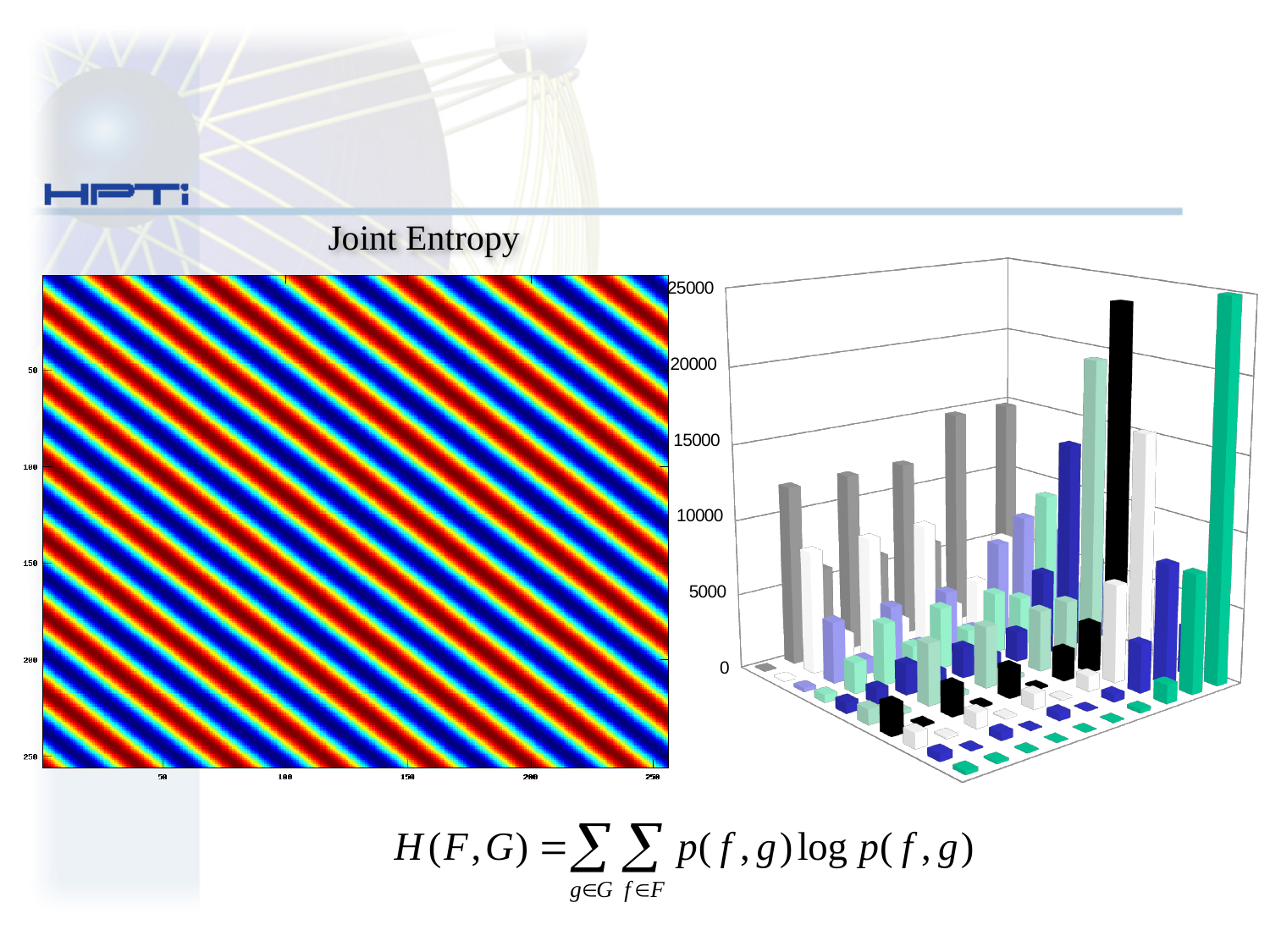
What is the highest value shown on the vertical axis of the bar chart on the right? 25000 What kind of chart is shown on the right side of the slide? bar chart In the bar chart on the right, is the value of the tallest grey bar greater or less than 20000? less What is the interval between consecutive tick marks on the vertical axis of the bar chart on the right? 5000 In the bar chart on the right, is the value of the tallest bar greater or less than 20000? greater